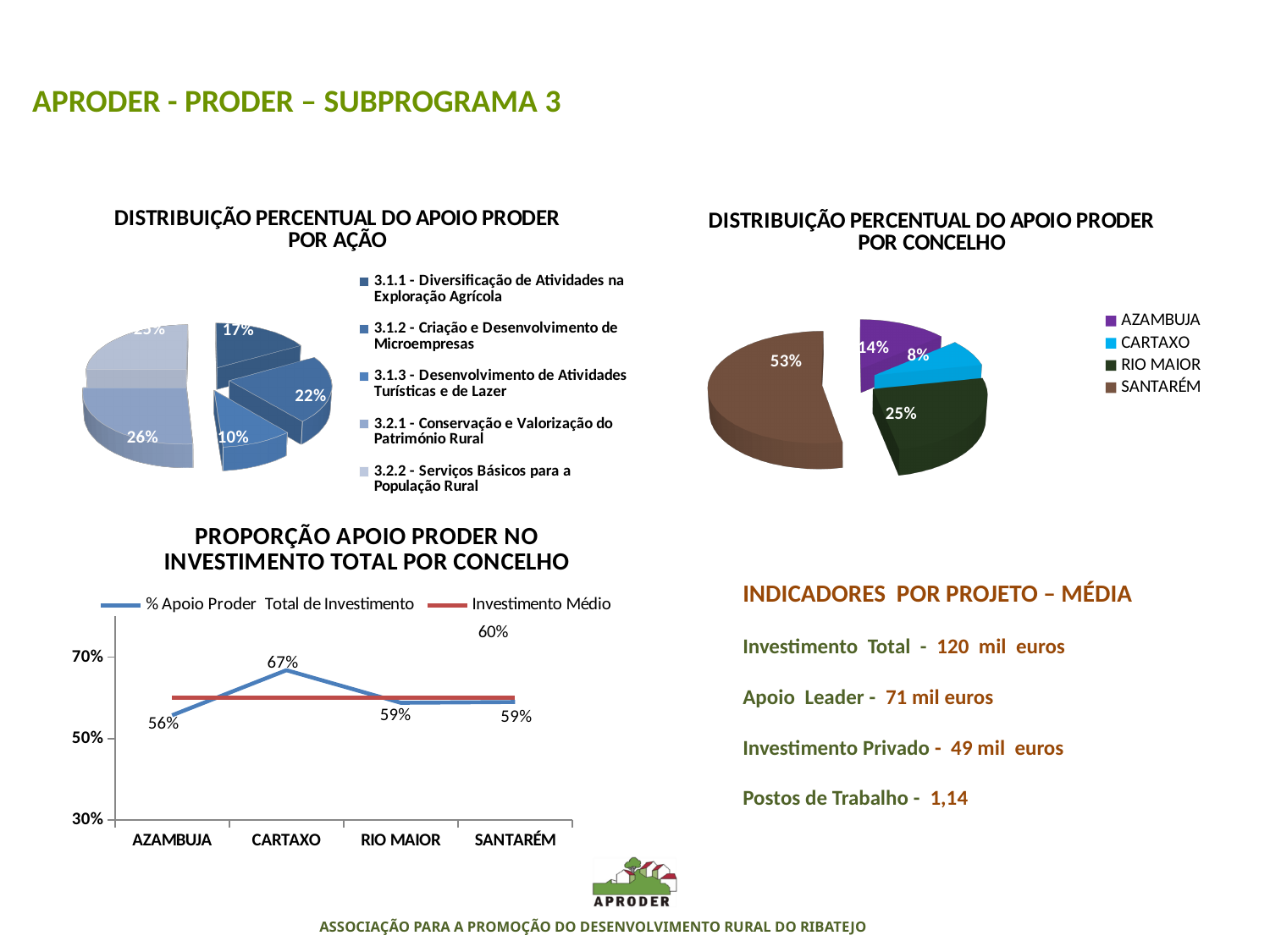
In the 'PROPORÇÃO APOIO PRODER NO INVESTIMENTO TOTAL POR CONCELHO' chart, which concelho has the lowest value? AZAMBUJA In the 'PROPORÇÃO APOIO PRODER NO INVESTIMENTO TOTAL POR CONCELHO' chart, which is larger, the value for CARTAXO or for RIO MAIOR? CARTAXO In the 'DISTRIBUIÇÃO PERCENTUAL DO APOIO PRODER POR CONCELHO' pie chart, what percentage is shown for SANTARÉM? 53% In the 'DISTRIBUIÇÃO PERCENTUAL DO APOIO PRODER POR CONCELHO' pie chart, which concelho has the smallest share? CARTAXO In the 'PROPORÇÃO APOIO PRODER NO INVESTIMENTO TOTAL POR CONCELHO' chart, what is the value for CARTAXO? 67% In the 'DISTRIBUIÇÃO PERCENTUAL DO APOIO PRODER POR CONCELHO' pie chart, how many percentage points larger is SANTARÉM's share than RIO MAIOR's? 28 percentage points What kind of chart is 'PROPORÇÃO APOIO PRODER NO INVESTIMENTO TOTAL POR CONCELHO'? Line chart How many concelhos are listed in the legend of the 'DISTRIBUIÇÃO PERCENTUAL DO APOIO PRODER POR CONCELHO' chart? 4 How many actions are listed in the legend of the 'DISTRIBUIÇÃO PERCENTUAL DO APOIO PRODER POR AÇÃO' pie chart? 5 In the 'DISTRIBUIÇÃO PERCENTUAL DO APOIO PRODER POR CONCELHO' pie chart, which concelho has the largest share? SANTARÉM In the 'PROPORÇÃO APOIO PRODER NO INVESTIMENTO TOTAL POR CONCELHO' chart, what value is labelled for the Investimento Médio line? 60% In the 'PROPORÇÃO APOIO PRODER NO INVESTIMENTO TOTAL POR CONCELHO' chart, how many series does the legend list? 2